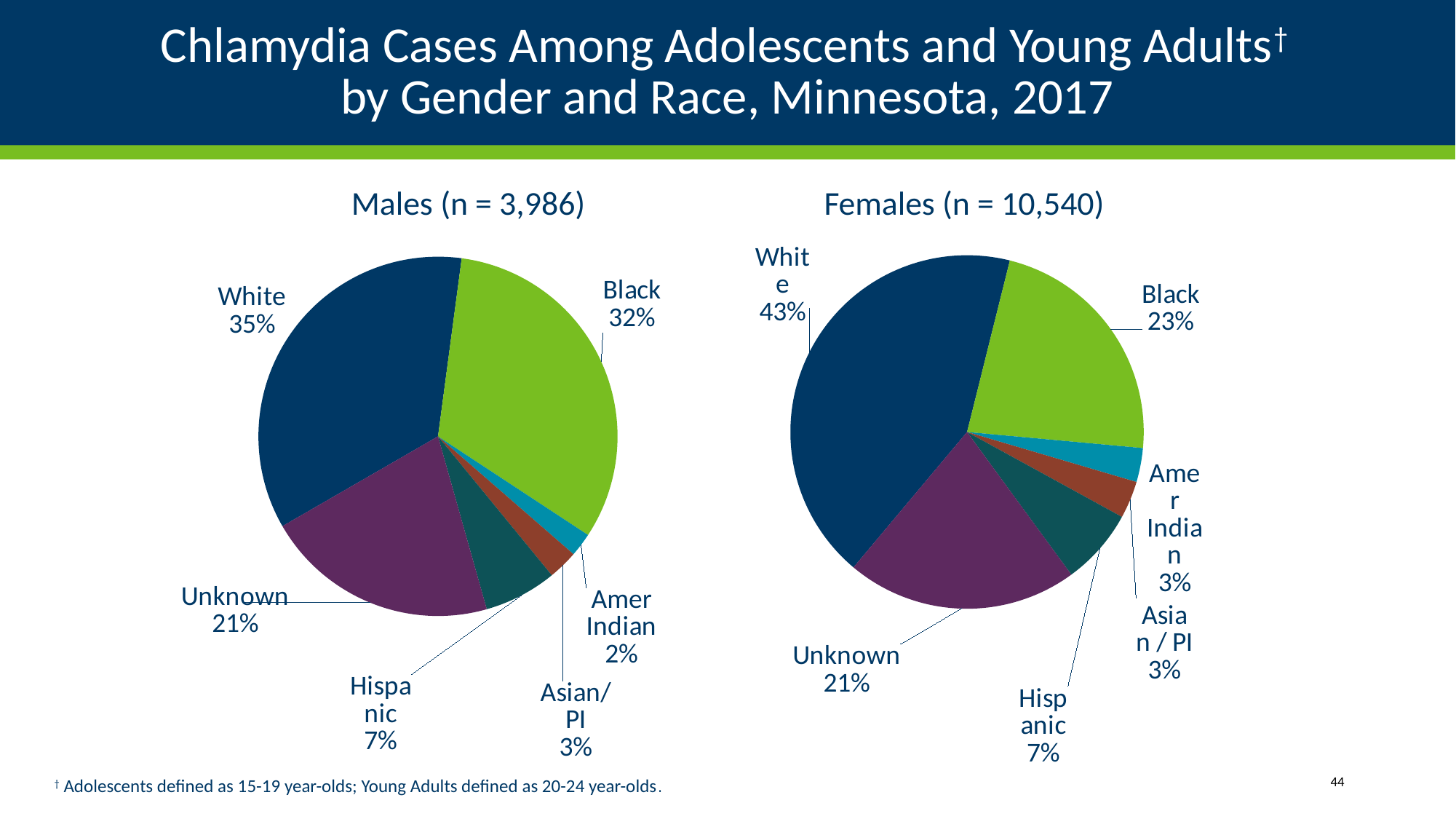
In the Females (n = 10,540) pie chart, what share of cases is Black? 23% What type of chart is used for the Females (n = 10,540) data? Pie chart In the Males pie chart, what share of cases is Hispanic? 7% In the Females pie chart, which race category has the largest share? White How many race categories are shown in the Males pie chart? 6 In the Males pie chart, which race category has the smallest share? Amer Indian In the Males pie chart, which race category has the largest share? White In the Females pie chart, what share of cases is Unknown? 21% In the Males (n = 3,986) pie chart, what share of cases is White? 35% In the Females pie chart, what is the difference between the White share and the Black share? 20 percentage points In the Males pie chart, which is larger, the Black share or the Unknown share? Black What is the sample size (n) shown in the title of the Males pie chart? 3,986